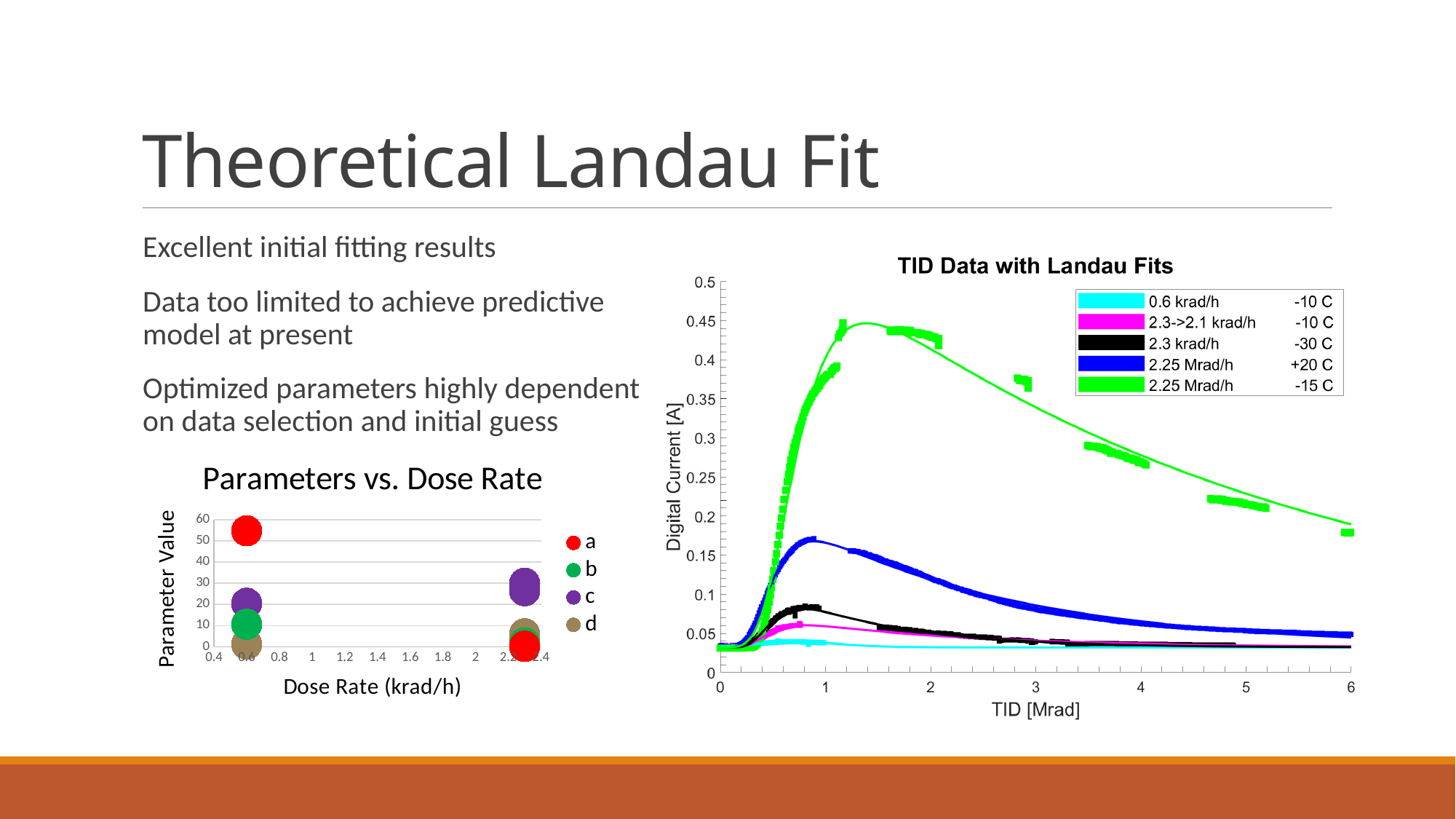
In the 'Parameters vs. Dose Rate' chart, what is the x-axis label? Dose Rate (krad/h) In the 'Parameters vs. Dose Rate' chart, how many series does the legend list? 4 In the 'TID Data with Landau Fits' chart, how many series does the legend list? 5 In the 'TID Data with Landau Fits' chart, is the peak digital current of the 2.25 Mrad/h -15 C series greater or less than 0.4? greater In the 'Parameters vs. Dose Rate' chart, is the value of series a at a dose rate of 0.6 krad/h greater or less than 50? greater In the 'TID Data with Landau Fits' chart, what is the y-axis label? Digital Current [A] In the 'Parameters vs. Dose Rate' chart, is the value of series c at a dose rate of 0.6 krad/h greater or less than 30? less In the 'Parameters vs. Dose Rate' chart, which series has the highest parameter value at a dose rate of 0.6 krad/h? a In the 'Parameters vs. Dose Rate' chart, which series has the highest parameter value at a dose rate of about 2.3 krad/h? c In the 'Parameters vs. Dose Rate' chart, which is larger at a dose rate of 0.6 krad/h: series b or series c? c In the 'TID Data with Landau Fits' chart, which series reaches the highest digital current? 2.25 Mrad/h -15 C